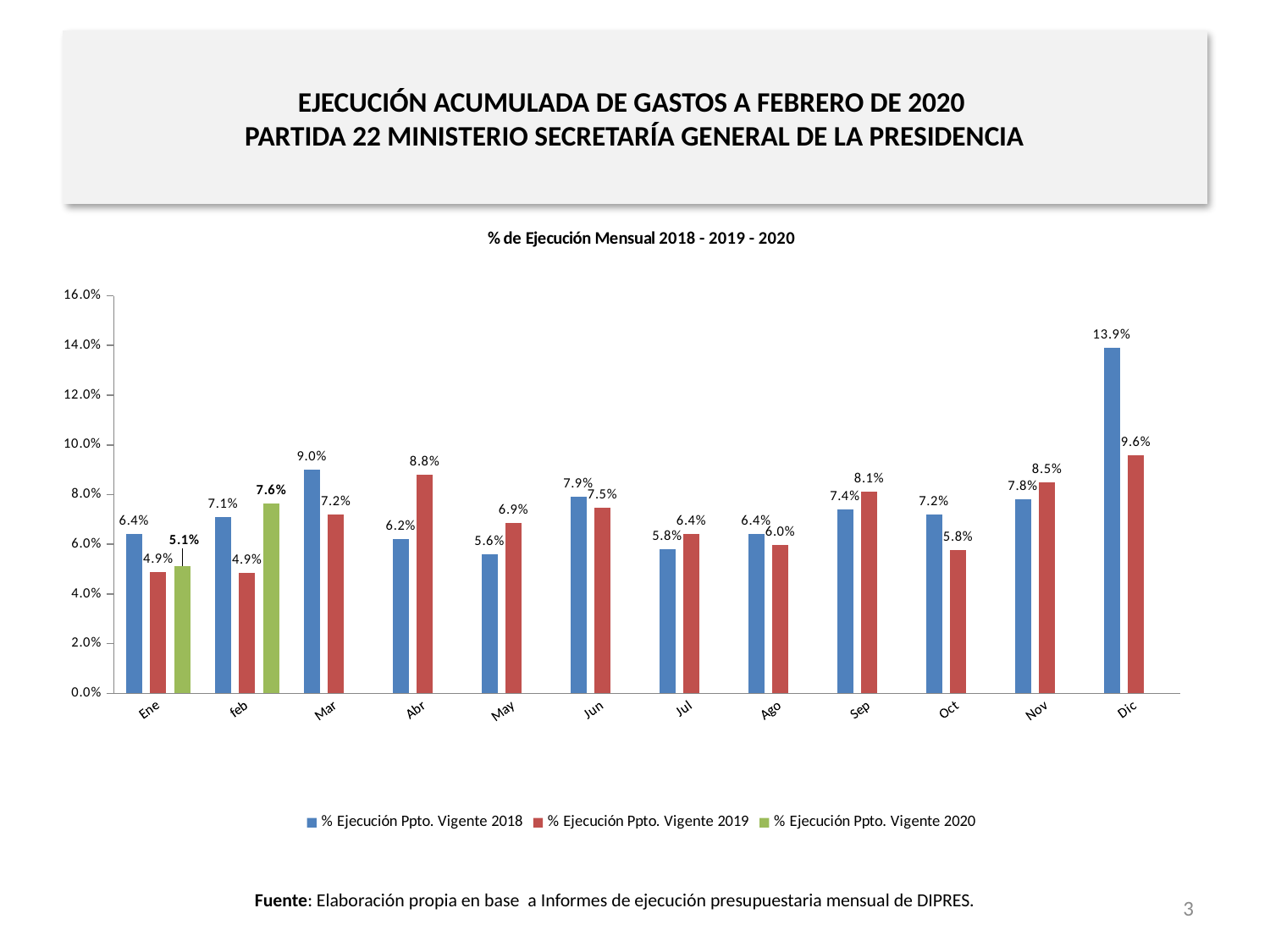
What is the value for % Ejecución Ppto. Vigente 2020 in feb? 7.6% Which month has the lowest value for % Ejecución Ppto. Vigente 2018? May What is the value for % Ejecución Ppto. Vigente 2019 in Abr? 8.8% What is the difference between the 2018 and 2019 values in Dic? 4.3% Which is larger in Mar: the 2018 value or the 2019 value? 2018 How many series does the legend list? 3 What kind of chart is shown on the slide? bar chart Which month has the highest value for % Ejecución Ppto. Vigente 2019? Dic What is the value for % Ejecución Ppto. Vigente 2018 in Dic? 13.9% Is the value for % Ejecución Ppto. Vigente 2018 in Dic greater or less than 12.0%? greater What colour are the bars for % Ejecución Ppto. Vigente 2020? green How many months are shown on the x axis? 12